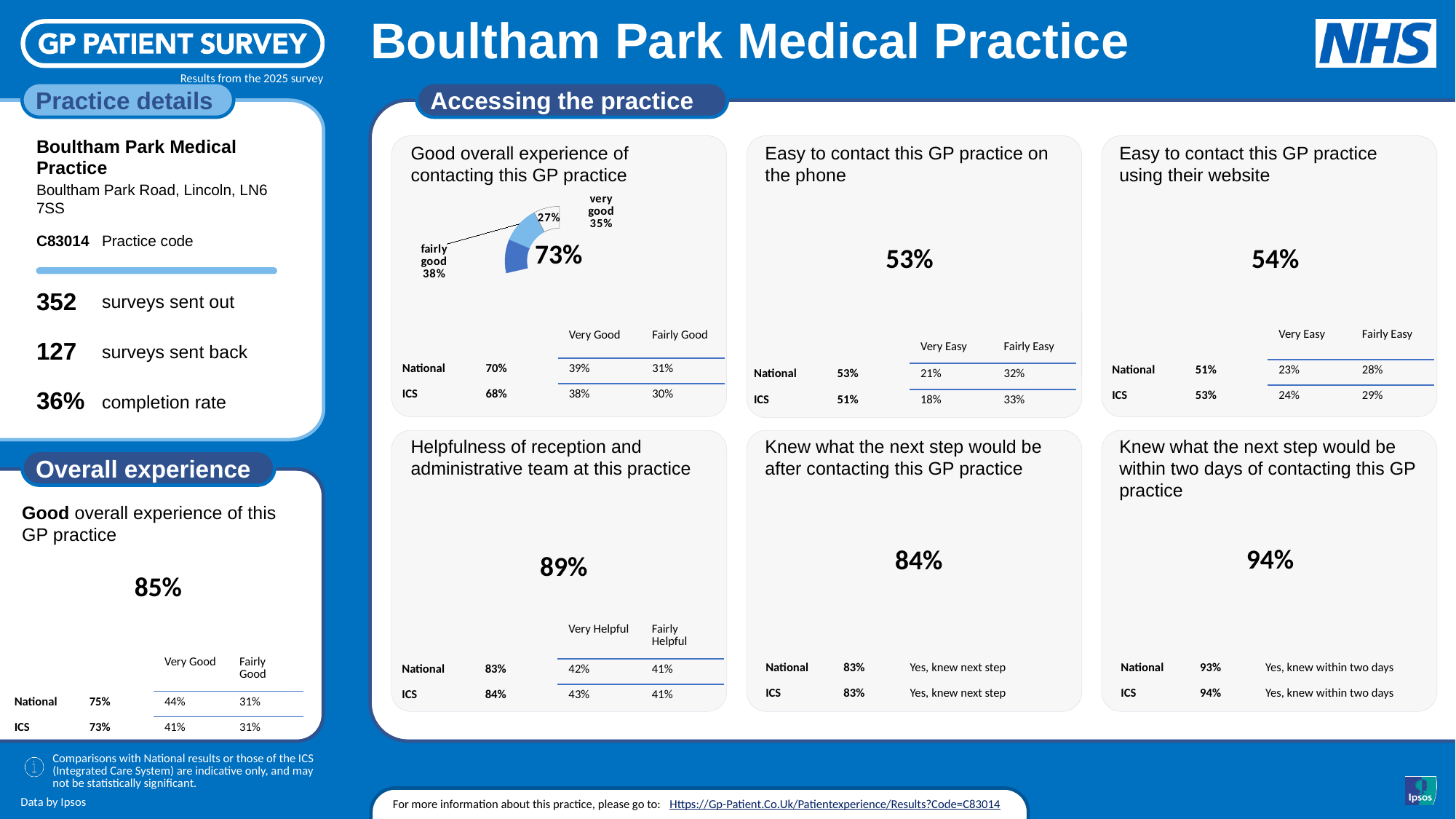
What kind of chart is shown in the 'Good overall experience of contacting this GP practice' panel? pie chart In the 'Good overall experience of contacting this GP practice' chart, is the 'very good' share greater or less than 30%? greater In the 'Good overall experience of contacting this GP practice' chart, is the 'fairly good' share greater or less than 40%? less In the 'Good overall experience of contacting this GP practice' chart, what is the difference between the 'fairly good' and 'very good' percentages? 3% In the 'Good overall experience of contacting this GP practice' chart, what percentage is labelled 'fairly good'? 38% What is the title of the panel containing the pie chart on the slide? Good overall experience of contacting this GP practice In the 'Good overall experience of contacting this GP practice' chart, what colour is the 'fairly good' slice? dark blue In the 'Good overall experience of contacting this GP practice' chart, which is larger: the 'very good' share or the 'fairly good' share? fairly good In the 'Good overall experience of contacting this GP practice' chart, what is the combined total of the 'very good' and 'fairly good' percentages? 73% In the 'Good overall experience of contacting this GP practice' chart, what is the large percentage printed in the centre of the chart? 73% In the 'Good overall experience of contacting this GP practice' chart, what percentage is labelled 'very good'? 35%